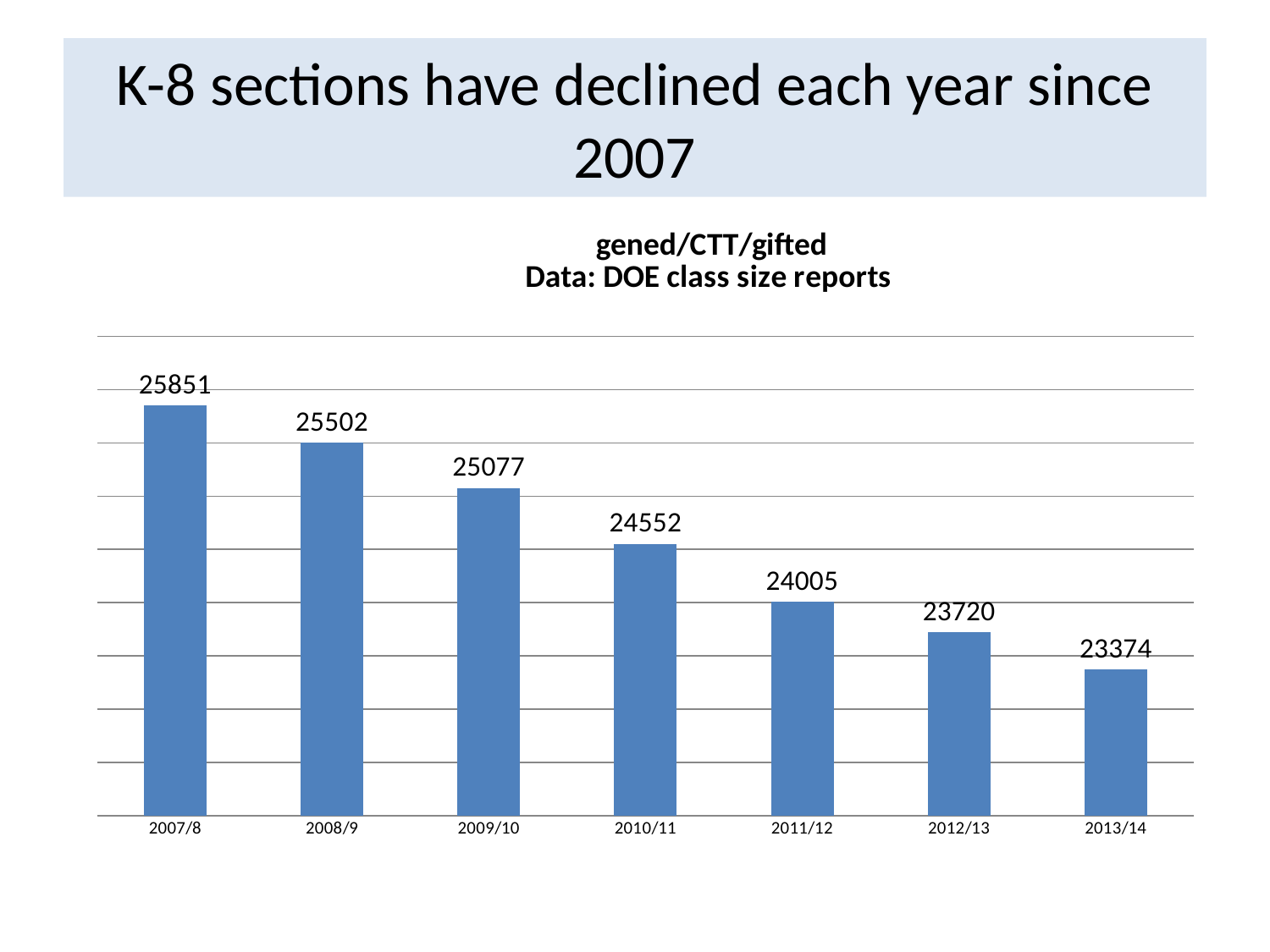
How many years are shown on the x axis? 7 What is the difference between the values for 2011/12 and 2012/13? 285 Which year has the highest value? 2007/8 What is the value for 2007/8? 25851 What is the value for 2010/11? 24552 Which year has the lowest value? 2013/14 What is the difference between the values for 2007/8 and 2013/14? 2477 What is the title of the chart? gened/CTT/gifted Data: DOE class size reports Which is larger, the value for 2009/10 or the value for 2011/12? 2009/10 Do the values rise or fall from 2007/8 to 2013/14? fall What kind of chart is this? bar chart What is the value for 2013/14? 23374